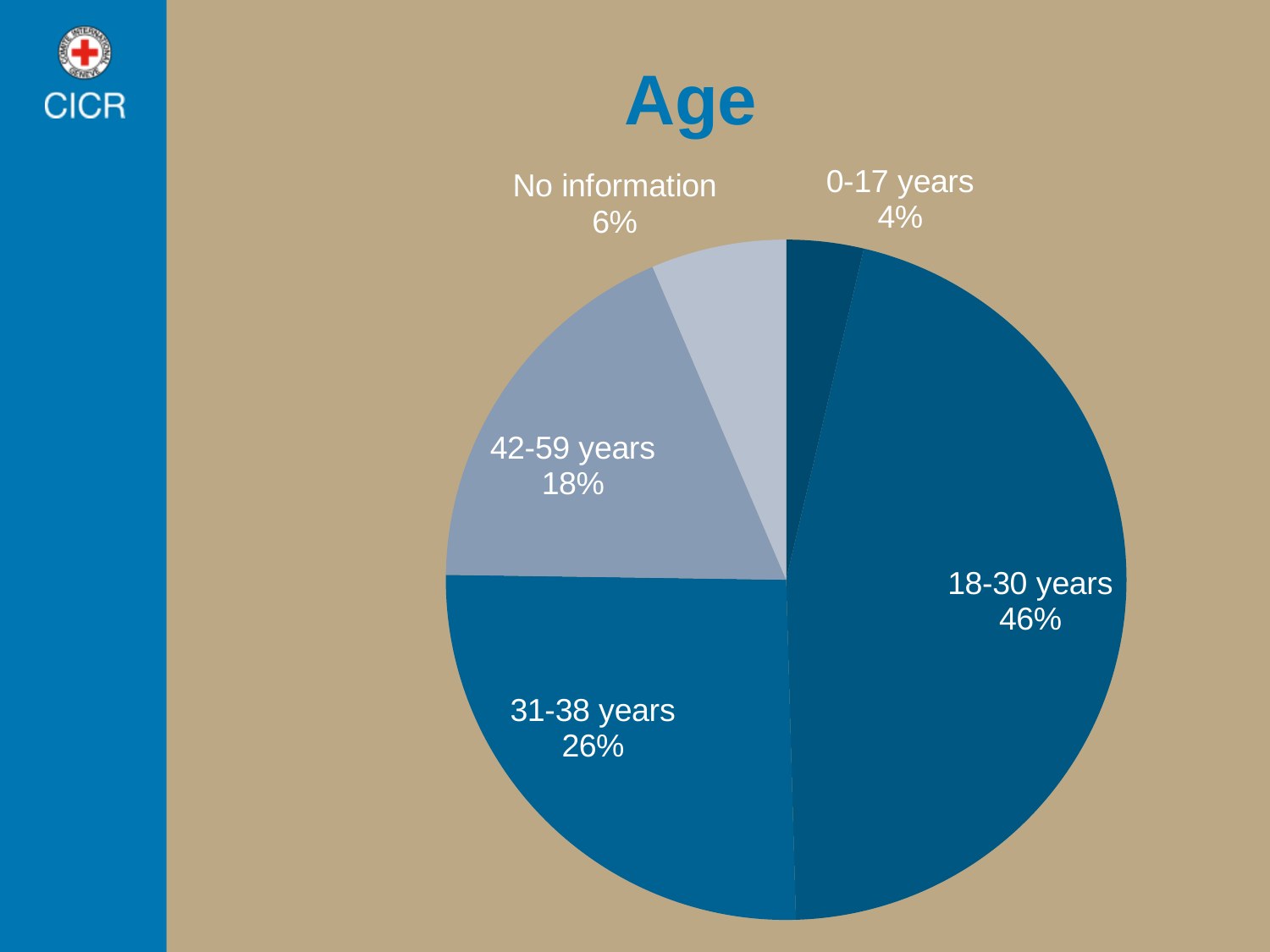
Which slice is larger, 42-59 years or No information? 42-59 years What share of the pie is the 31-38 years slice? 26% Which age category has the largest share of the pie? 18-30 years What share of the pie is the 0-17 years slice? 4% What share of the pie is the No information slice? 6% What is the difference in percentage points between the 18-30 years slice and the 31-38 years slice? 20 Which category has the smallest share of the pie? 0-17 years What is the title of the chart? Age How many slices does the pie chart have? 5 What share of the pie is the 18-30 years slice? 46% What share of the pie is the 42-59 years slice? 18% What kind of chart is shown on the slide? pie chart